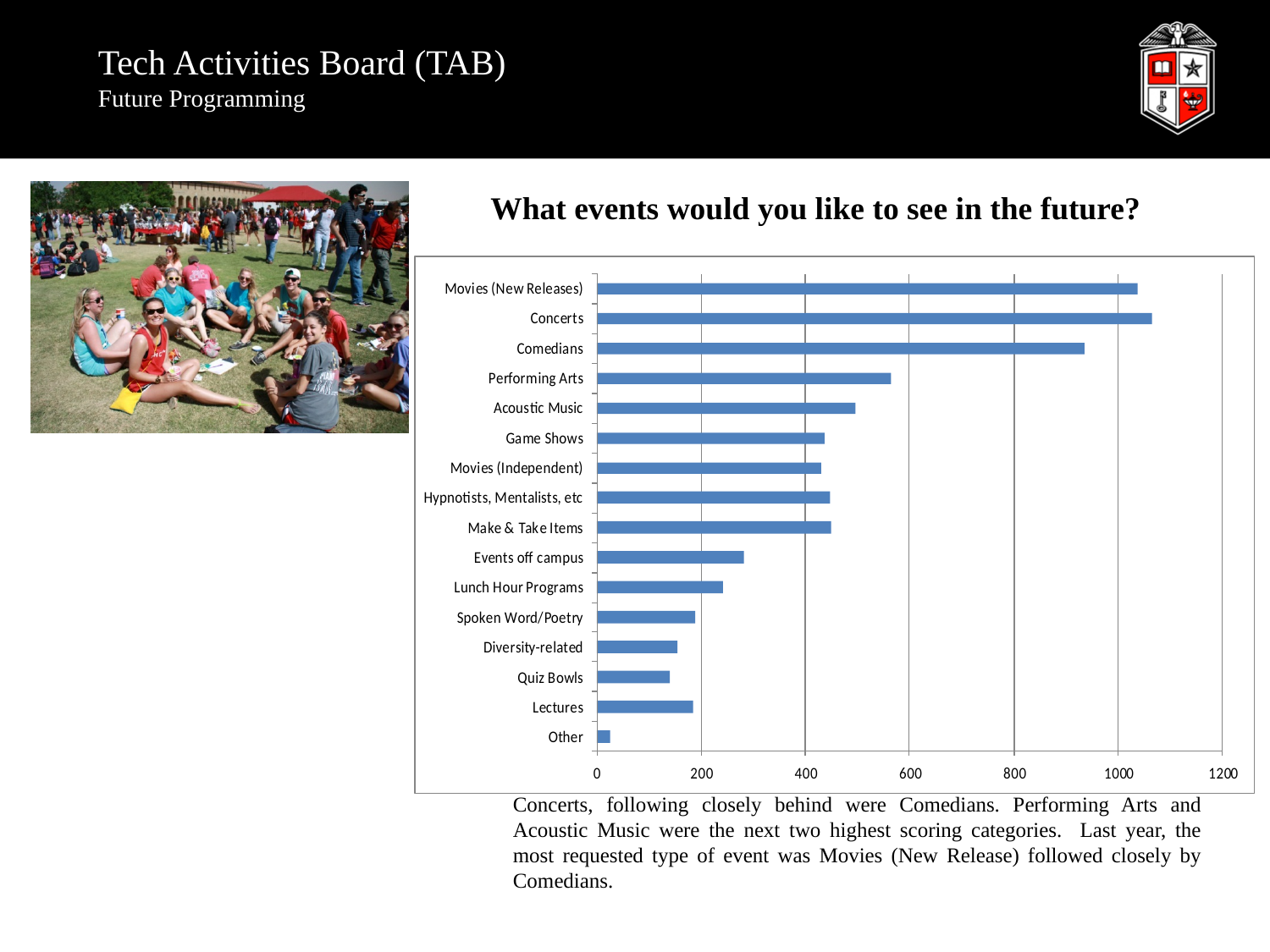
What is the title of the chart? What events would you like to see in the future? Which has a higher value, Spoken Word/Poetry or Quiz Bowls? Spoken Word/Poetry Is the value for Acoustic Music greater or less than 600? less Which has a higher value, Performing Arts or Acoustic Music? Performing Arts Is the value for Comedians greater or less than 800? greater Is the value for Quiz Bowls greater or less than 200? less How many event categories are plotted in the chart? 16 What kind of chart is shown on the slide? Bar chart Which event category has the lowest value in the chart? Other